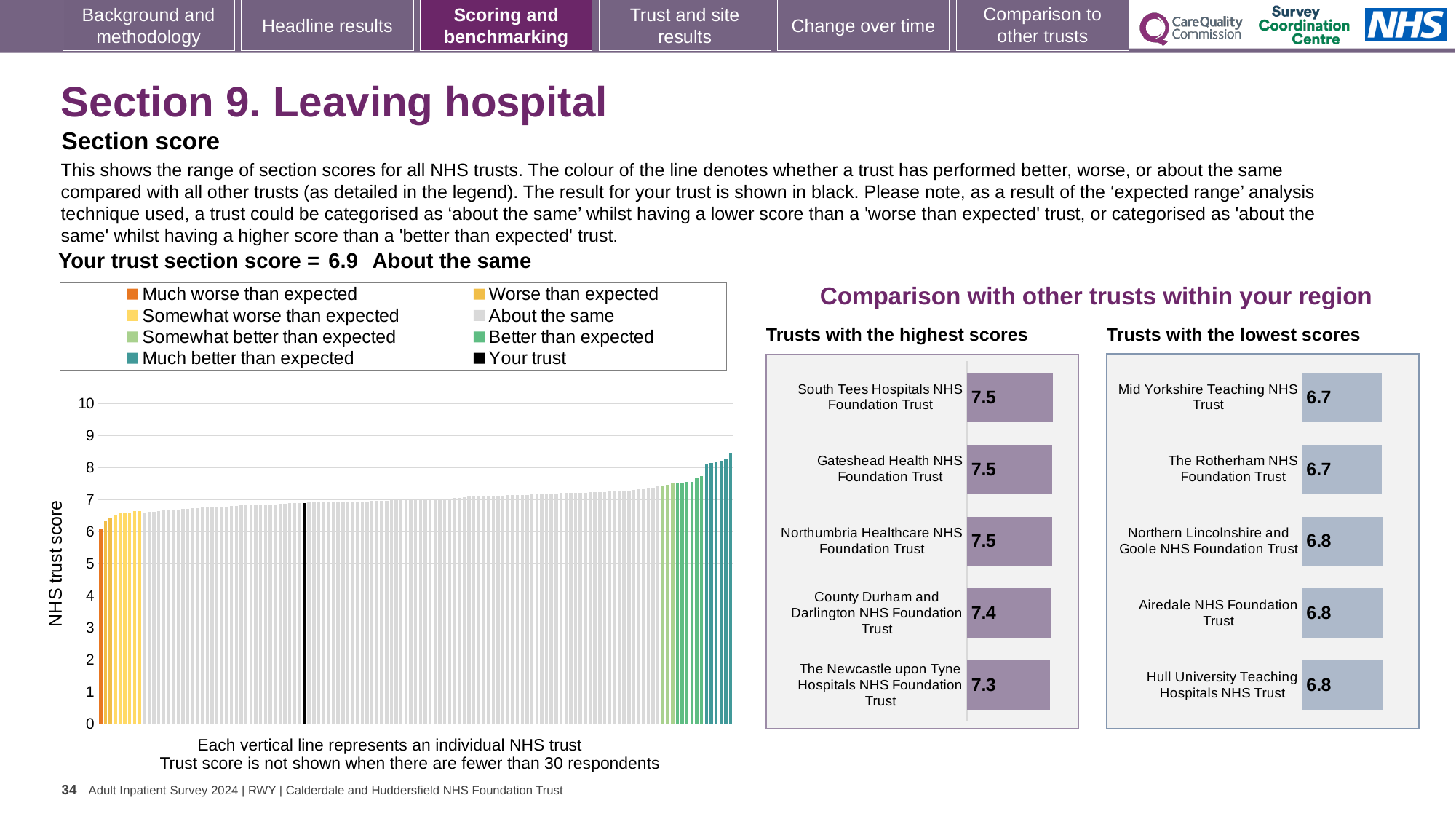
In the 'Trusts with the highest scores' chart, which trust has the lowest score? The Newcastle upon Tyne Hospitals NHS Foundation Trust In the large chart on the left showing NHS trust scores, do the values rise or fall from left to right? Rise In the 'Trusts with the lowest scores' chart, which is larger: the score for Northern Lincolnshire and Goole NHS Foundation Trust or the score for The Rotherham NHS Foundation Trust? Northern Lincolnshire and Goole NHS Foundation Trust In the 'Trusts with the highest scores' chart, what is the score for Gateshead Health NHS Foundation Trust? 7.5 In the 'Trusts with the highest scores' chart, what is the score for The Newcastle upon Tyne Hospitals NHS Foundation Trust? 7.3 In the 'Trusts with the highest scores' chart, how many trusts are listed? 5 In the 'Trusts with the highest scores' chart, what is the difference between the scores of South Tees Hospitals NHS Foundation Trust and The Newcastle upon Tyne Hospitals NHS Foundation Trust? 0.2 In the 'Trusts with the lowest scores' chart, what is the score for Mid Yorkshire Teaching NHS Trust? 6.7 In the large chart on the left showing NHS trust scores, what kind of chart is it? Bar chart In the large chart on the left showing NHS trust scores, how many entries does the legend list? 8 In the 'Trusts with the lowest scores' chart, what is the score for Airedale NHS Foundation Trust? 6.8 In the 'Trusts with the lowest scores' chart, what is the difference between the scores of Hull University Teaching Hospitals NHS Trust and Mid Yorkshire Teaching NHS Trust? 0.1